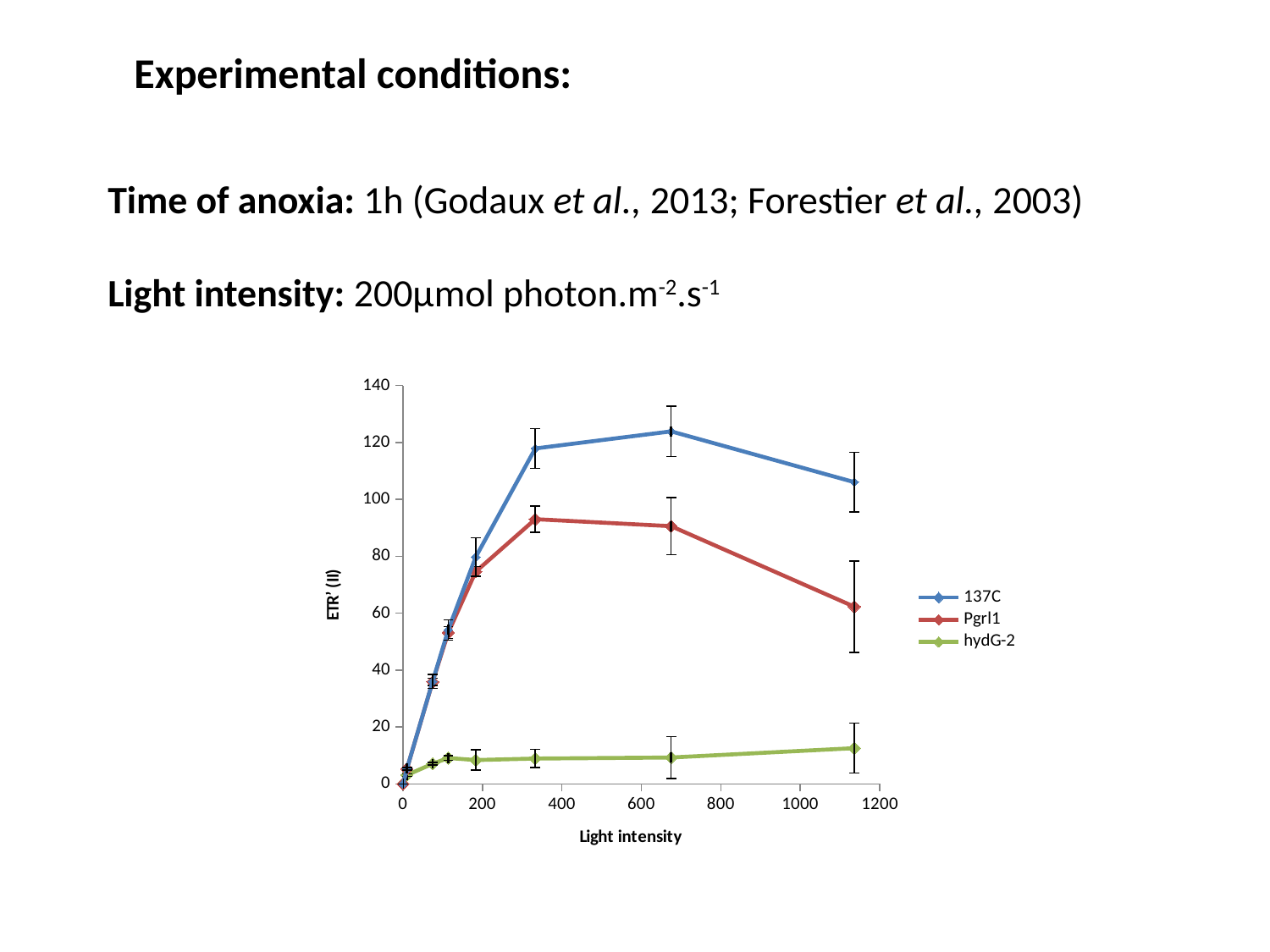
What kind of chart is shown on the slide? line chart Does the 137C series rise or fall as light intensity increases from 0 to 200? rise What is the label of the chart's x axis? Light intensity Is the ETR' (II) value for 137C at a light intensity of about 670 greater or less than 100? greater How many series does the chart legend list? 3 Does the Pgrl1 series rise or fall as light intensity increases from about 670 to about 1140? fall Is the ETR' (II) value for hydG-2 at a light intensity of about 1140 greater or less than 20? less Is the ETR' (II) value for Pgrl1 at a light intensity of about 1140 greater or less than 80? less At a light intensity of about 670, which series has the larger ETR' (II) value, 137C or Pgrl1? 137C Which series reaches the highest ETR' (II) value on the chart? 137C Which series has the lowest ETR' (II) values across the light intensity range? hydG-2